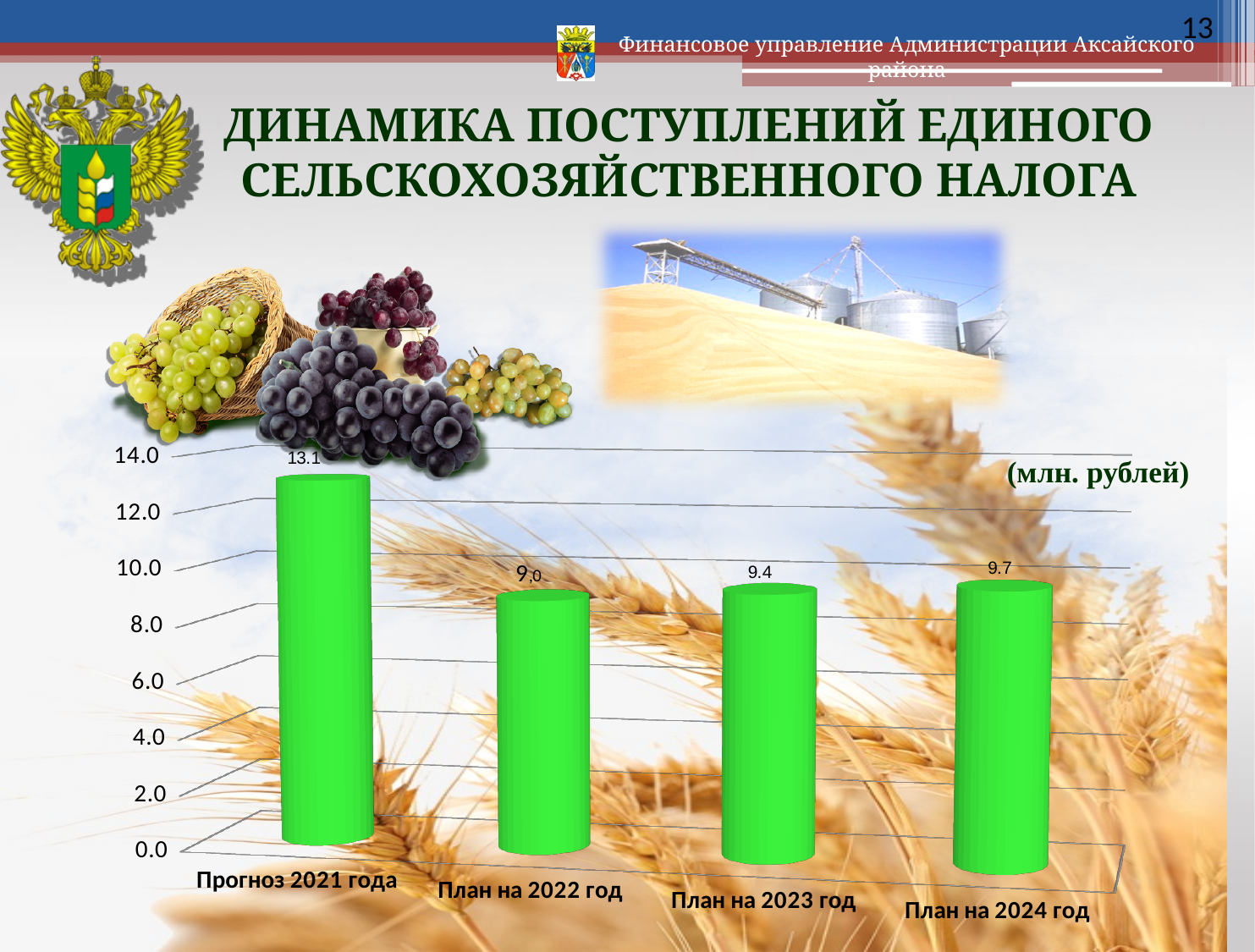
Which category has the highest value? Прогноз 2021 года What is the value for План на 2022 год? 9,0 What is the value for План на 2023 год? 9.4 How many categories are shown in the chart? 4 What is the difference between the values for Прогноз 2021 года and План на 2022 год? 4.1 What is the value for Прогноз 2021 года? 13.1 What is the difference between the values for План на 2024 год and План на 2023 год? 0.3 In what units are the chart values given? млн. рублей Which category has the lowest value? План на 2022 год What is the value for План на 2024 год? 9.7 What kind of chart is shown on the slide? Bar chart Which is larger, the value for План на 2023 год or План на 2024 год? План на 2024 год